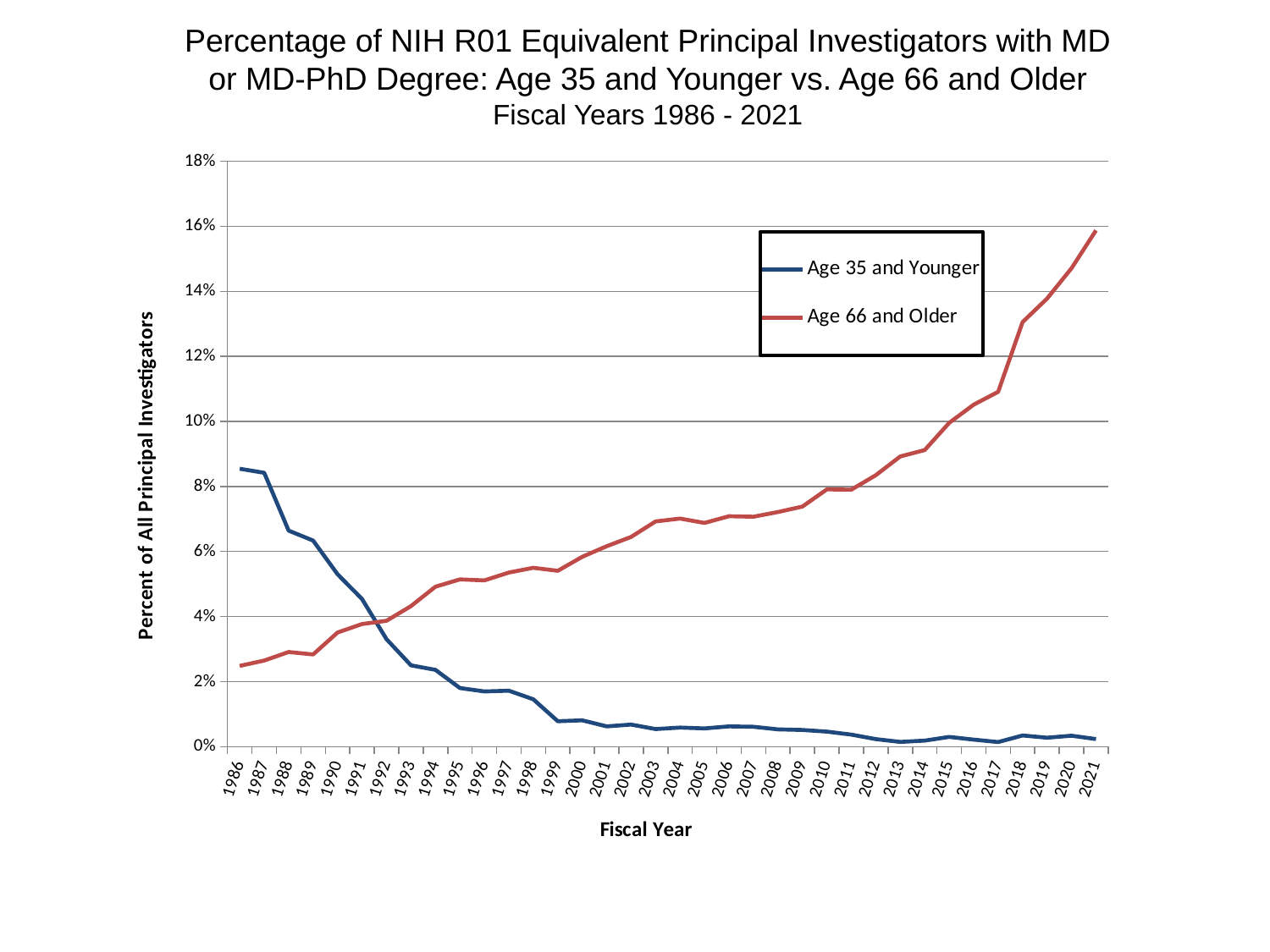
Does the Age 66 and Older line rise or fall from 1986 to 2021? rise In which fiscal year is the Age 66 and Older series at its highest? 2021 Is the value for Age 66 and Older in 2021 greater or less than 14%? greater Is the value for Age 35 and Younger in 1986 greater or less than 8%? greater How many series does the legend list? 2 Does the Age 35 and Younger line rise or fall from 1986 to 2021? fall How many fiscal years are plotted along the x axis? 36 Is the value for Age 35 and Younger in 2013 greater or less than 2%? less In 2021, which series has the higher value, Age 35 and Younger or Age 66 and Older? Age 66 and Older In 1986, which series has the higher value, Age 35 and Younger or Age 66 and Older? Age 35 and Younger What kind of chart is shown on the slide? line chart